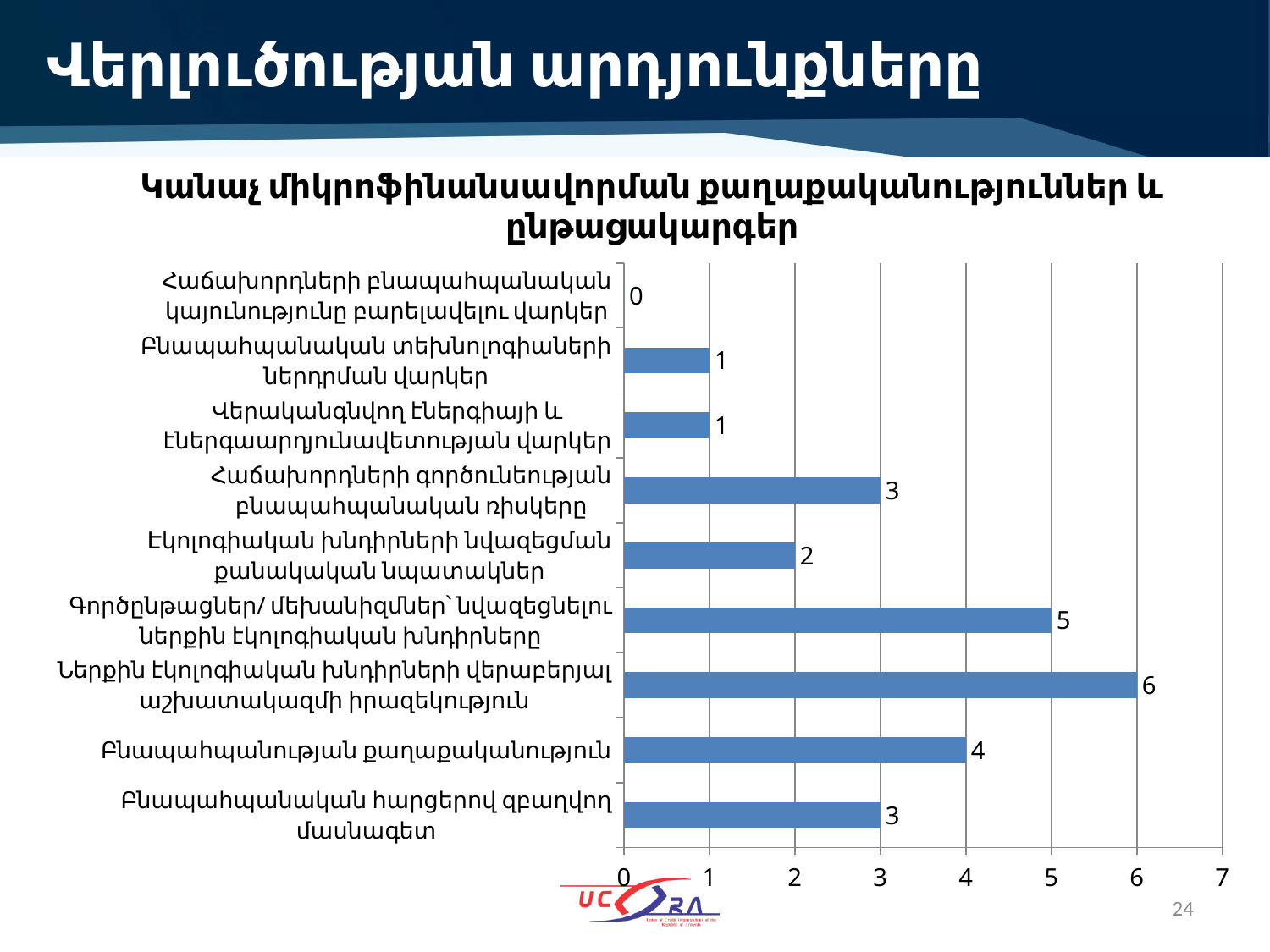
What type of chart is shown on the slide? Bar chart Which category has the highest value? Ներքին էկոլոգիական խնդիրների վերաբերյալ աշխատակազմի իրազեկություն Which category has the lowest value? Հաճախորդների բնապահպանական կայունությունը բարելավելու վարկեր What is the value for "Էկոլոգիական խնդիրների նվազեցման քանակական նպատակներ"? 2 What is the title of the chart? Կանաչ միկրոֆինանսավորման քաղաքականություններ և ընթացակարգեր What is the difference between the values for "Գործընթացներ/ մեխանիզմներ՝ նվազեցնելու ներքին էկոլոգիական խնդիրները" and "Բնապահպանական հարցերով զբաղվող մասնագետ"? 2 How many categories are shown in the chart? 9 What is the value for "Ներքին էկոլոգիական խնդիրների վերաբերյալ աշխատակազմի իրազեկություն"? 6 What is the value for "Բնապահպանության քաղաքականություն"? 4 Which is larger: the value for "Բնապահպանության քաղաքականություն" or the value for "Հաճախորդների գործունեության բնապահպանական ռիսկերը"? Բնապահպանության քաղաքականություն What is the maximum value shown on the horizontal axis? 7 What is the value for "Հաճախորդների բնապահպանական կայունությունը բարելավելու վարկեր"? 0